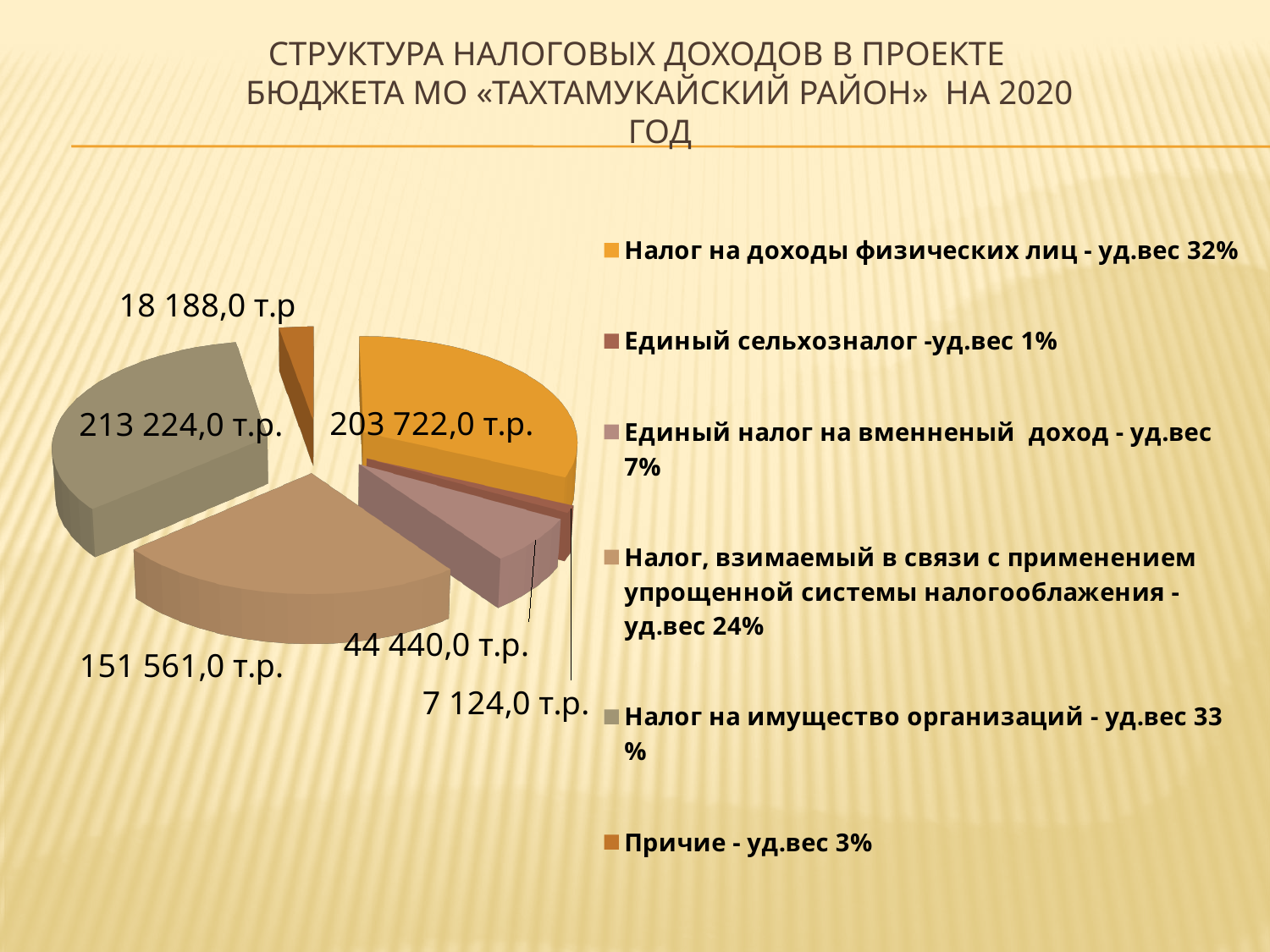
Which is larger: the value for Единый налог на вменненый доход or the value for Причие? Единый налог на вменненый доход Which category has the smallest value in the pie chart? Единый сельхозналог How many slices does the pie chart have? 6 What share of the pie does Налог на доходы физических лиц represent, according to the legend? 32% What colour is the slice for Налог на имущество организаций? grey-green What is the value shown for Налог на доходы физических лиц? 203 722,0 т.р. What is the difference between the values for Налог на имущество организаций and Налог на доходы физических лиц? 9 502,0 т.р. What is the value shown for Единый сельхозналог? 7 124,0 т.р. What is the value shown for Налог, взимаемый в связи с применением упрощенной системы налогооблажения? 151 561,0 т.р. What is the value shown for Налог на имущество организаций? 213 224,0 т.р. Which category has the largest value in the pie chart? Налог на имущество организаций What kind of chart is shown on the slide? pie chart